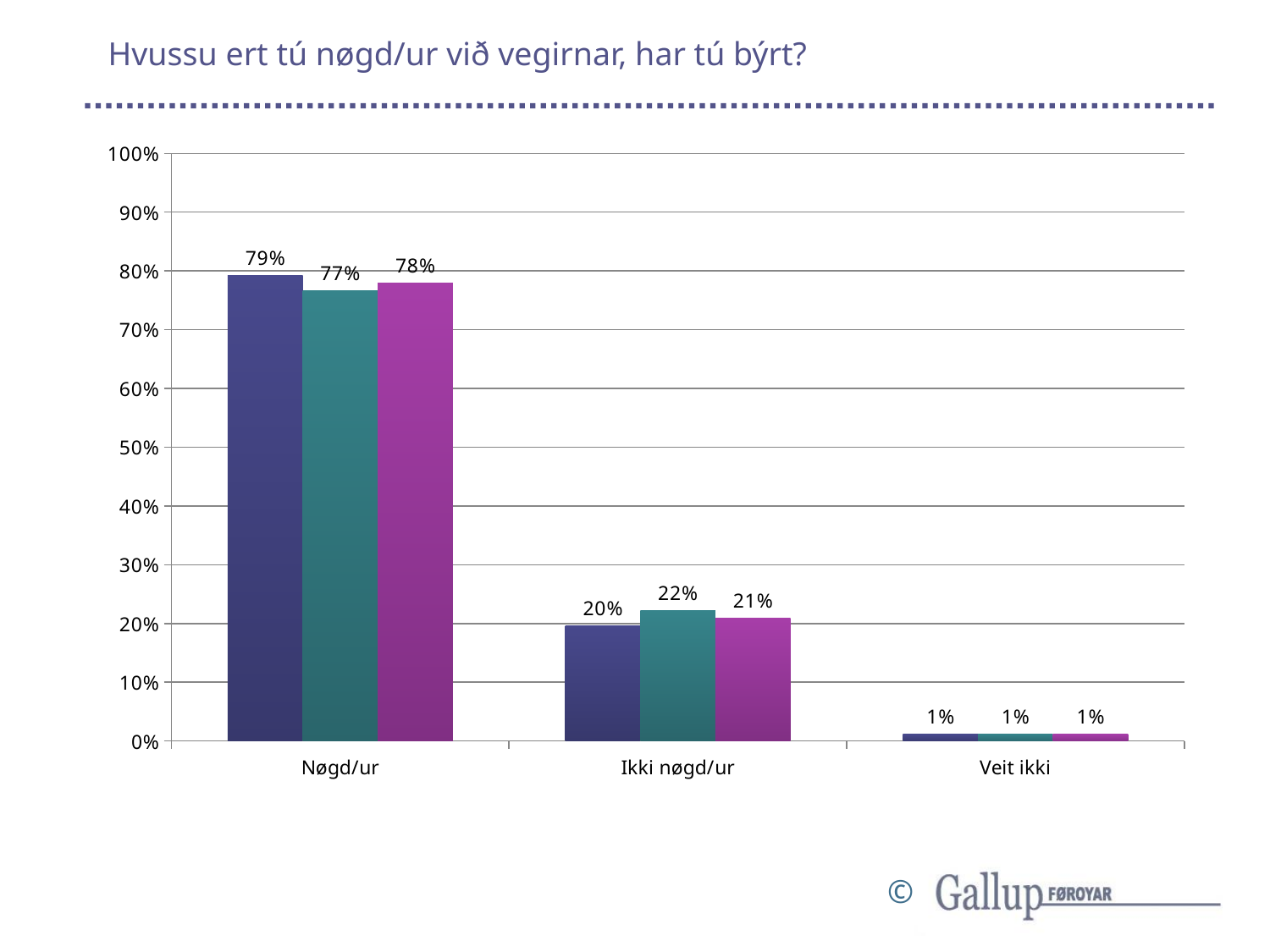
What is the value of the dark blue bar for Veit ikki? 1% What is the difference between the dark blue bar for Nøgd/ur and the dark blue bar for Ikki nøgd/ur? 59% What is the value of the first (dark blue) bar for Nøgd/ur? 79% Which category has the lowest values across all three bars? Veit ikki What is the value of the teal bar for Ikki nøgd/ur? 22% Which category has the highest values across all three bars? Nøgd/ur Which is larger for Nøgd/ur: the dark blue bar or the teal bar? the dark blue bar How many categories are shown on the x axis? 3 What is the value of the magenta bar for Nøgd/ur? 78% What kind of chart is shown on the slide? bar chart What is the title of the slide? Hvussu ert tú nøgd/ur við vegirnar, har tú býrt? What is the difference between the teal bar and the dark blue bar for Ikki nøgd/ur? 2%